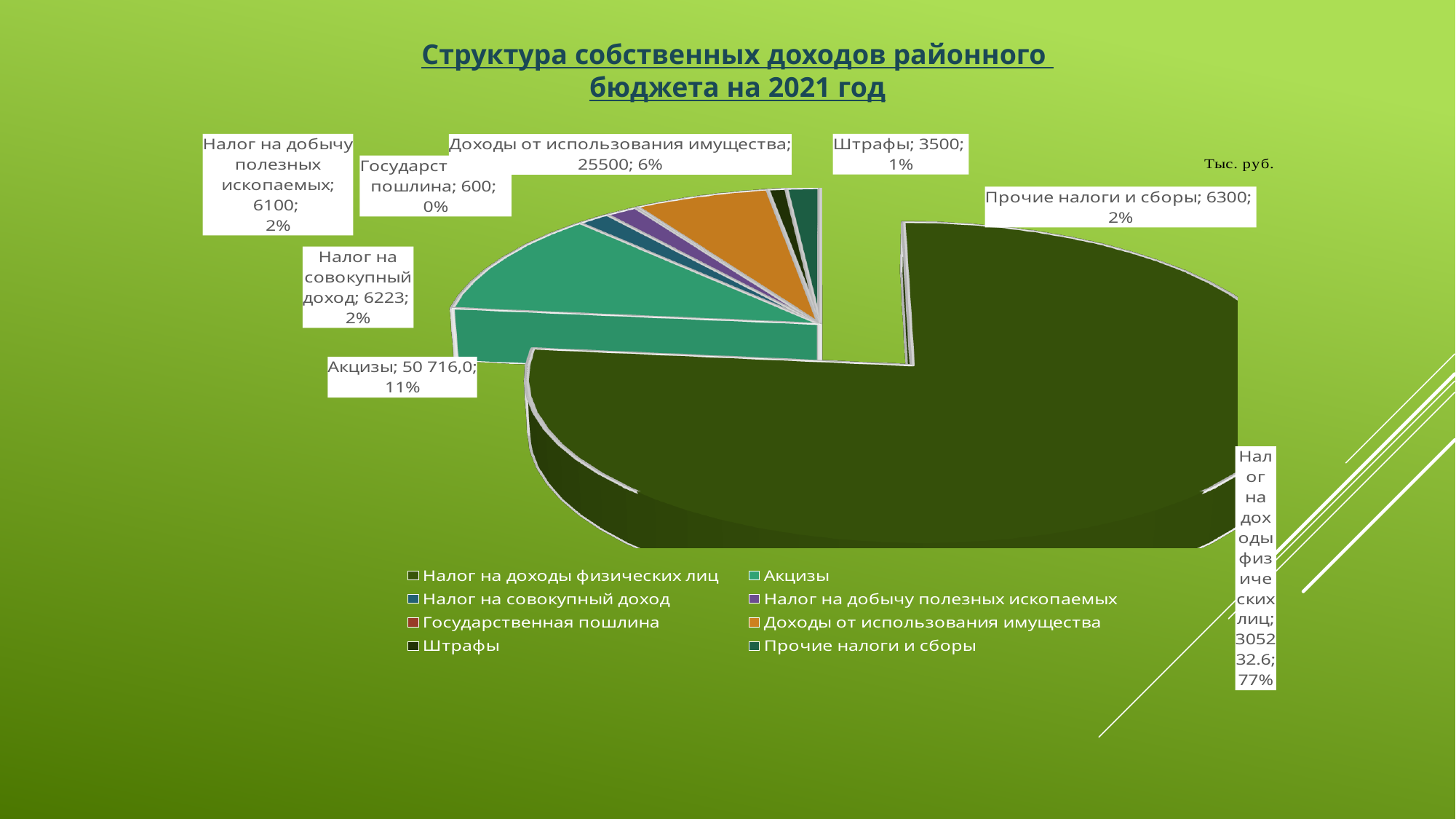
What share of the pie does Налог на доходы физических лиц take? 77% Which category has the smallest slice of the pie? Государственная пошлина Which is larger: the value for Налог на совокупный доход or the value for Налог на добычу полезных ископаемых? Налог на совокупный доход What is the value for Акцизы? 50 716,0 What kind of chart is shown on the slide? pie chart What is the difference between the values for Прочие налоги и сборы and Налог на добычу полезных ископаемых? 200 What is the value for Доходы от использования имущества? 25500 Which category has the largest slice of the pie? Налог на доходы физических лиц What is the value for Штрафы? 3500 What share of the pie does Акцизы take? 11% How many categories does the legend list? 8 What unit is indicated for the values on the chart? Тыс. руб.